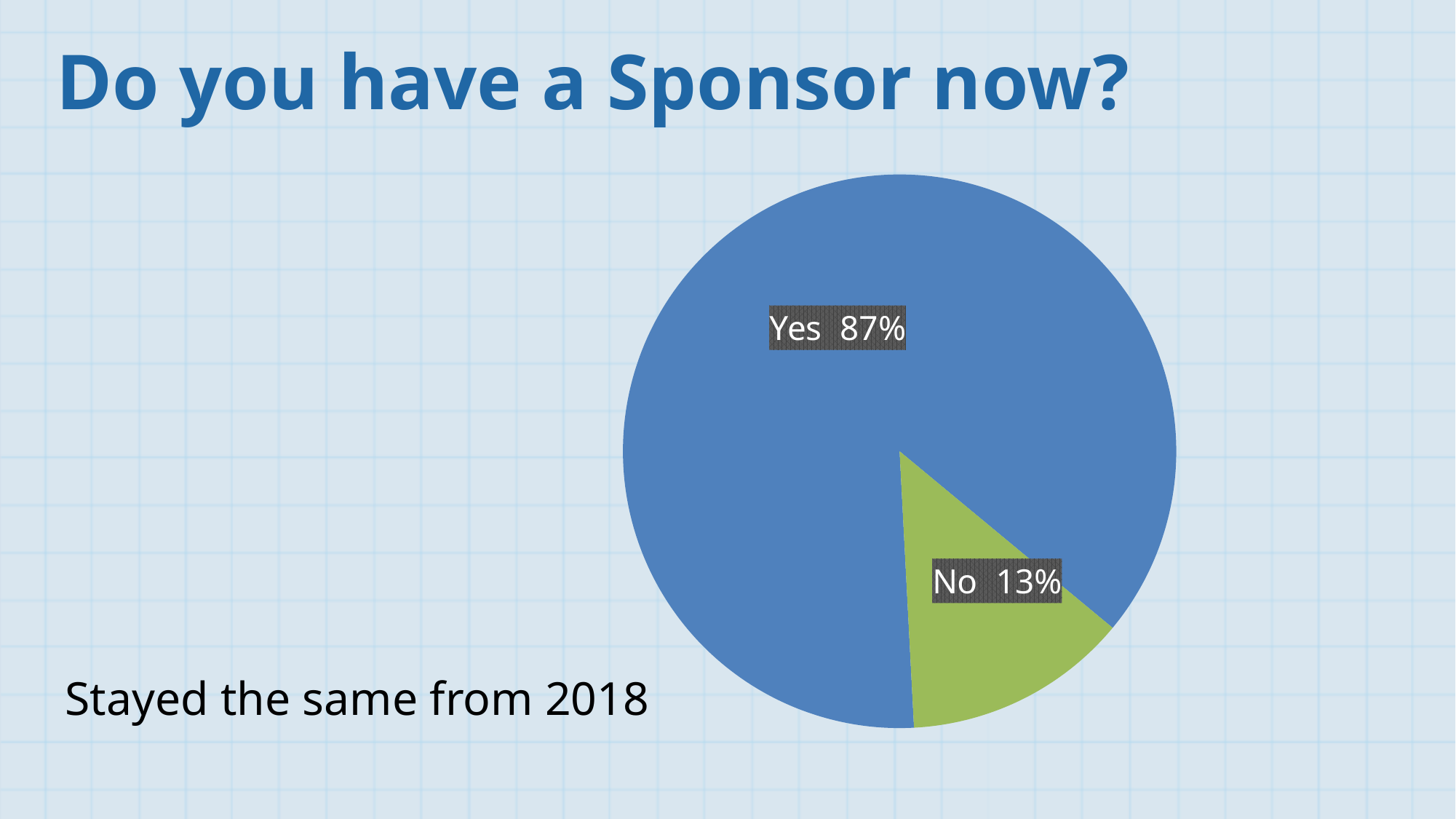
What percentage of respondents answered Yes? 87% Which response has the largest share of the pie? Yes Which response has the smallest share of the pie? No Which slice is larger, Yes or No? Yes What is the difference in percentage points between the Yes and No slices? 74 What share of the pie does the No slice represent? 13% How many slices does the pie chart have? 2 What colour is the Yes slice? Blue What percentage of respondents answered No? 13% What kind of chart is shown on the slide? Pie chart What is the title of the slide containing the chart? Do you have a Sponsor now?